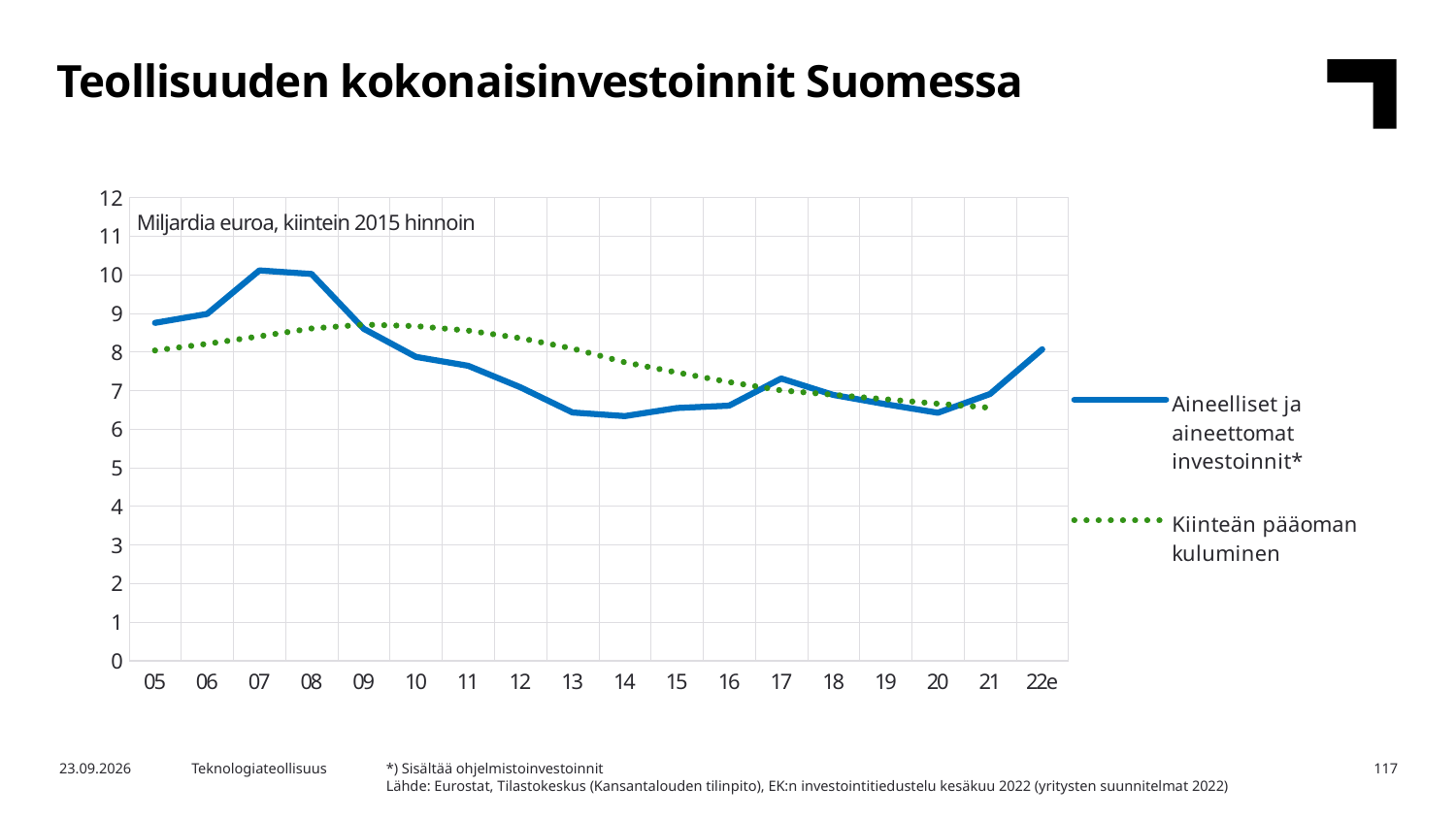
How many series does the legend list? 2 Does the 'Aineelliset ja aineettomat investoinnit*' line rise or fall from 08 to 14? Fall How many years (categories) are shown on the x axis? 18 Is the value of 'Aineelliset ja aineettomat investoinnit*' in 22e greater or less than 7? greater Is the value of 'Aineelliset ja aineettomat investoinnit*' in 05 greater or less than 8? greater Is the value of 'Kiinteän pääoman kuluminen' in 21 greater or less than 7? less What unit is stated inside the chart area? Miljardia euroa, kiintein 2015 hinnoin What is the title of the chart? Teollisuuden kokonaisinvestoinnit Suomessa In 13, which series has the higher value: 'Aineelliset ja aineettomat investoinnit*' or 'Kiinteän pääoman kuluminen'? Kiinteän pääoman kuluminen In 07, which series has the higher value: 'Aineelliset ja aineettomat investoinnit*' or 'Kiinteän pääoman kuluminen'? Aineelliset ja aineettomat investoinnit* What kind of chart is shown on the slide? Line chart